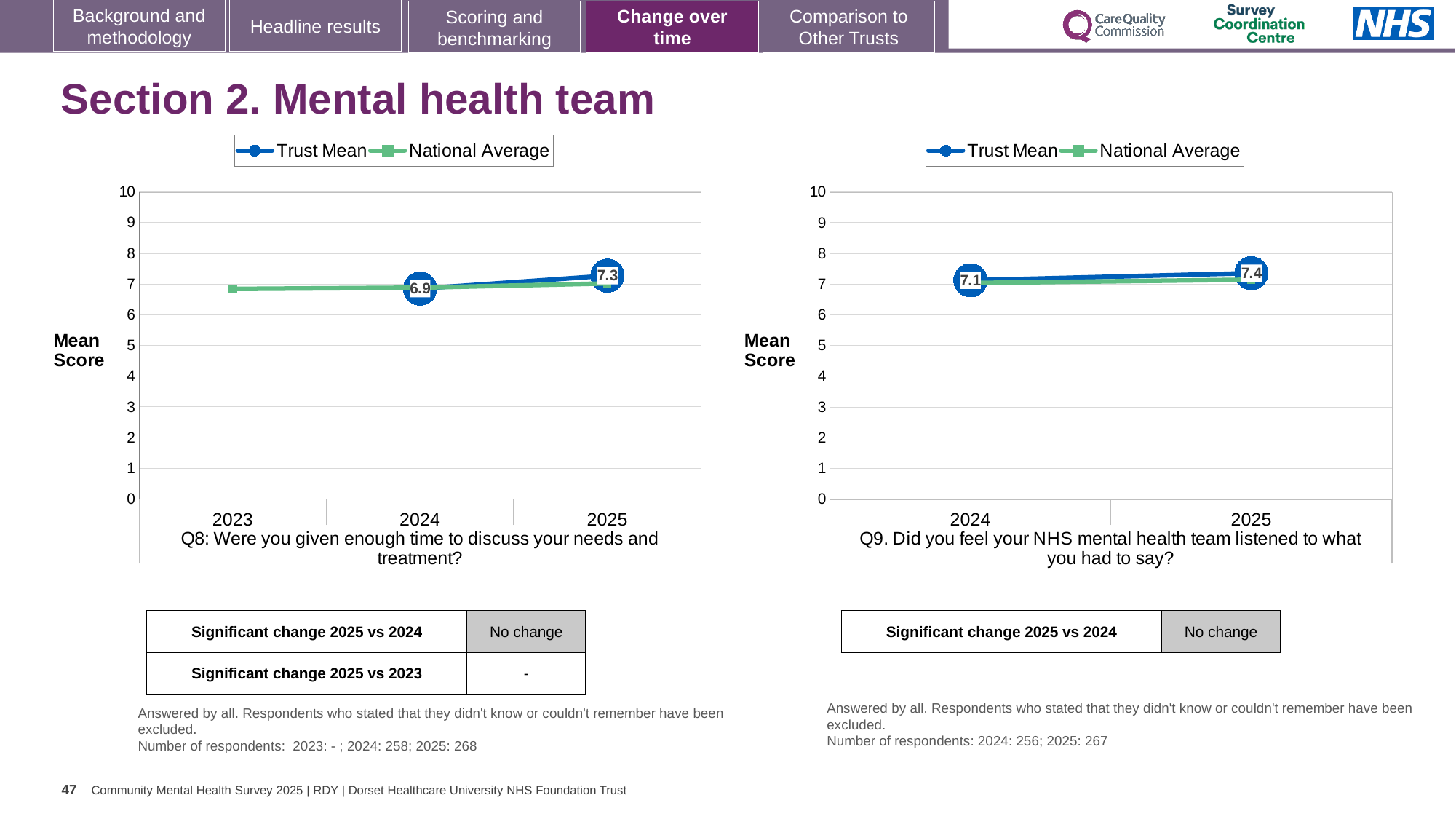
In the Q8 chart (left), what is the Trust Mean for 2024? 6.9 In the Q8 chart (left), is the National Average for 2023 greater or less than 8? less How many series does the legend of the Q9 chart (right) list? 2 In the Q9 chart (right), what is the Trust Mean for 2025? 7.4 In the Q8 chart (left), by how much did the Trust Mean change from 2024 to 2025? 0.4 In the Q9 chart (right), does the Trust Mean rise or fall from 2024 to 2025? rise In the Q8 chart (left), what is the Trust Mean for 2025? 7.3 In the Q9 chart (right), what is the difference between the Trust Mean in 2025 and in 2024? 0.3 How many years are shown on the x axis of the Q8 chart (left)? 3 In the Q8 chart (left), which year has the higher Trust Mean, 2024 or 2025? 2025 In the Q9 chart (right), what is the Trust Mean for 2024? 7.1 What type of chart is the Q9 chart (right)? line chart